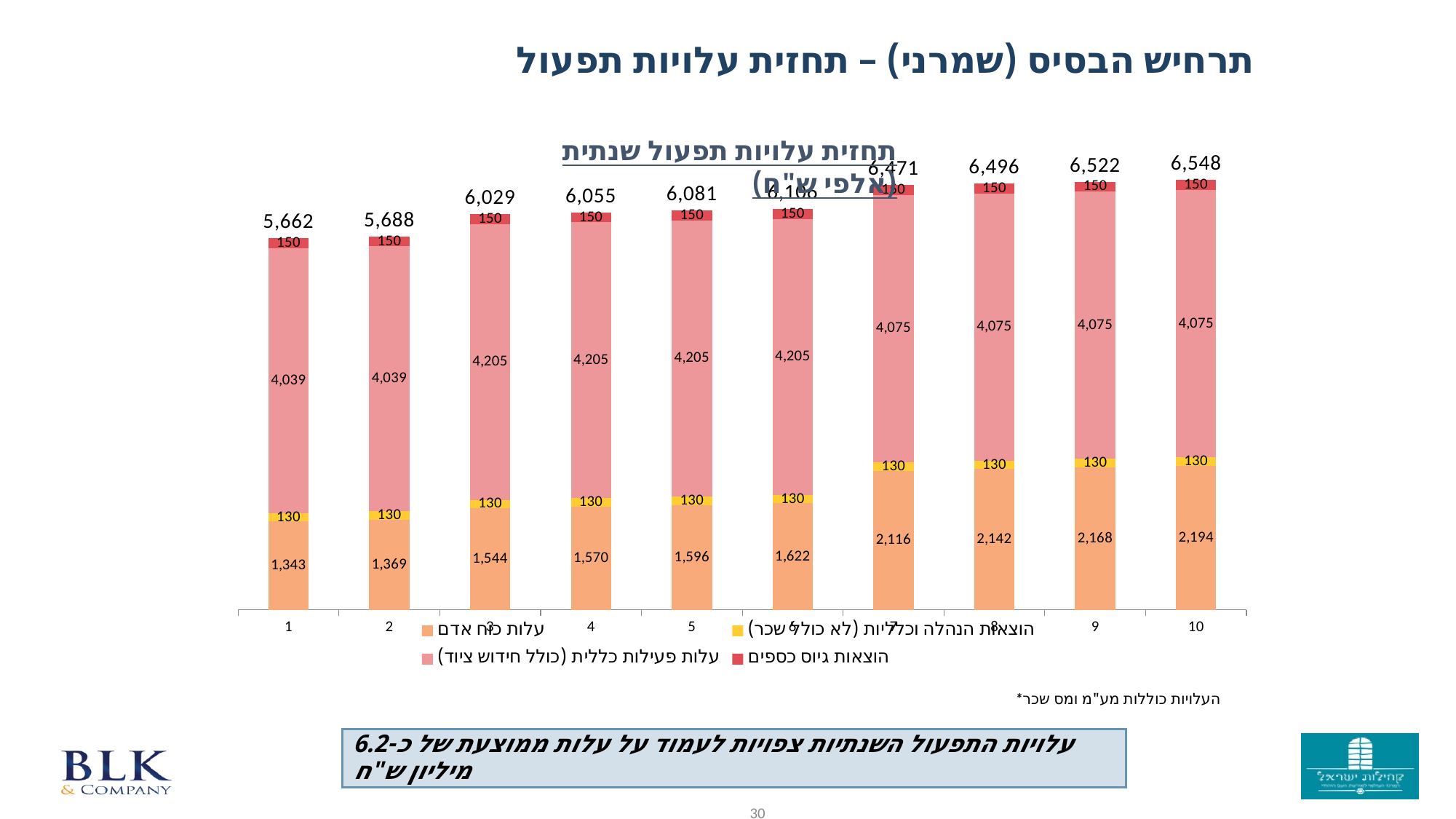
What is the value of עלות כח אדם for year 7? 2,116 What is the difference between the עלות כח אדם values for year 10 and year 1? 851 What type of chart is shown on the slide? stacked bar chart Which year has the highest total operating cost? 10 How many categories (years) are shown on the x axis of the chart? 10 What is the total value of the stacked bar for year 10? 6,548 What is the value of עלות פעילות כללית (כולל חידוש ציוד) for year 4? 4,205 What is the value of הוצאות גיוס כספים for year 3? 150 Do the total values rise or fall from year 1 to year 10? rise Which year has the lowest total operating cost? 1 What is the total value of the stacked bar for year 1? 5,662 How many series does the chart legend list? 4